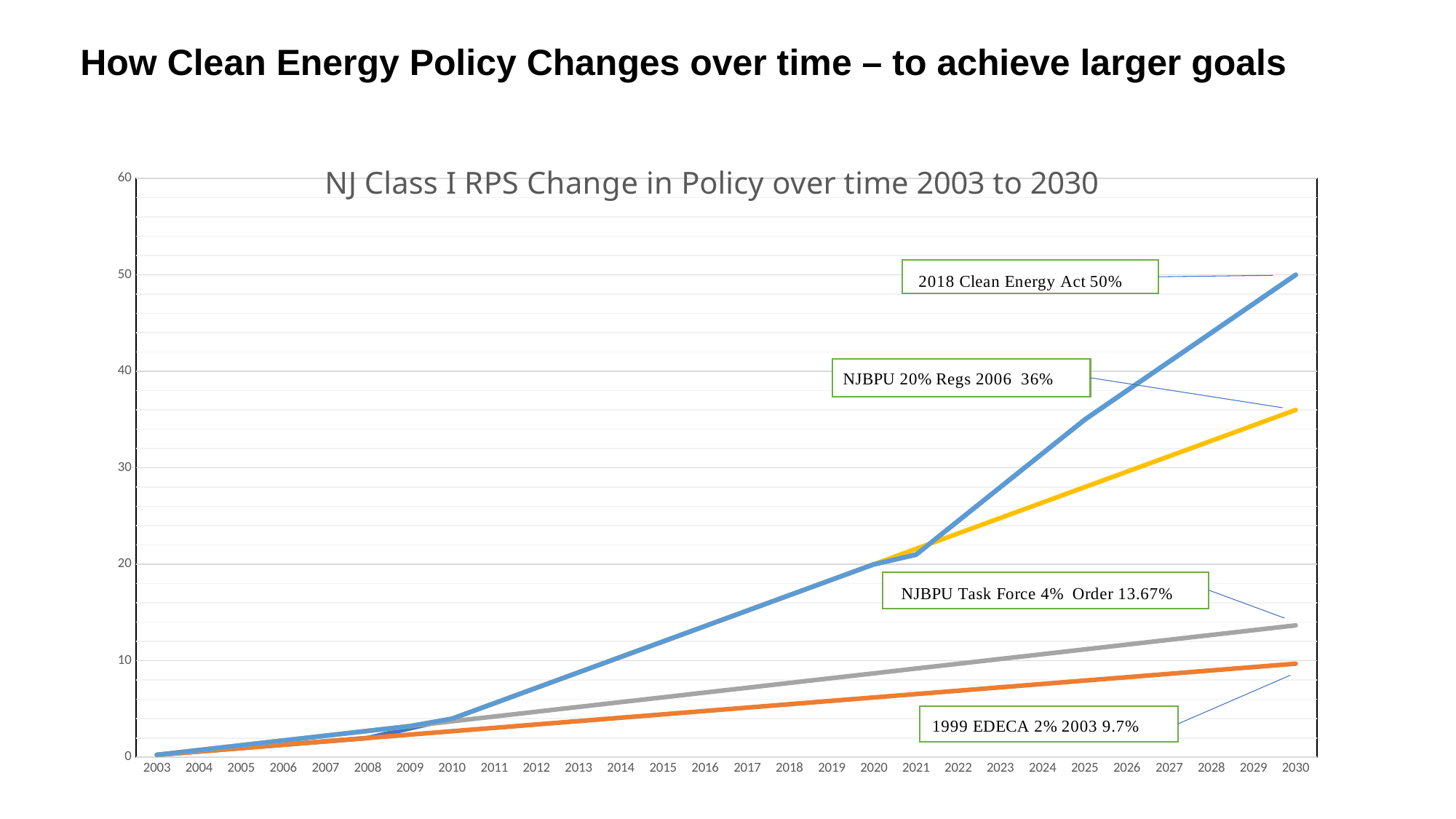
Is the value of the blue 2018 Clean Energy Act line in 2025 greater or less than 30? greater What kind of chart is shown on the slide? line chart According to the annotation, what value does the NJBPU Task Force 4% Order line reach? 13.67% How many years are labelled along the x axis? 28 Which policy line reaches the highest value in 2030? 2018 Clean Energy Act According to the annotation, what value does the NJBPU 20% Regs 2006 line reach? 36% According to the annotation, what value does the 2018 Clean Energy Act line reach? 50% How many lines are plotted on the chart? 4 Which policy line reaches the lowest value in 2030? 1999 EDECA Do the values of the blue 2018 Clean Energy Act line rise or fall from 2003 to 2030? rise According to the annotation, what value does the 1999 EDECA 2% 2003 line reach? 9.7% What is the title of the chart? NJ Class I RPS Change in Policy over time 2003 to 2030